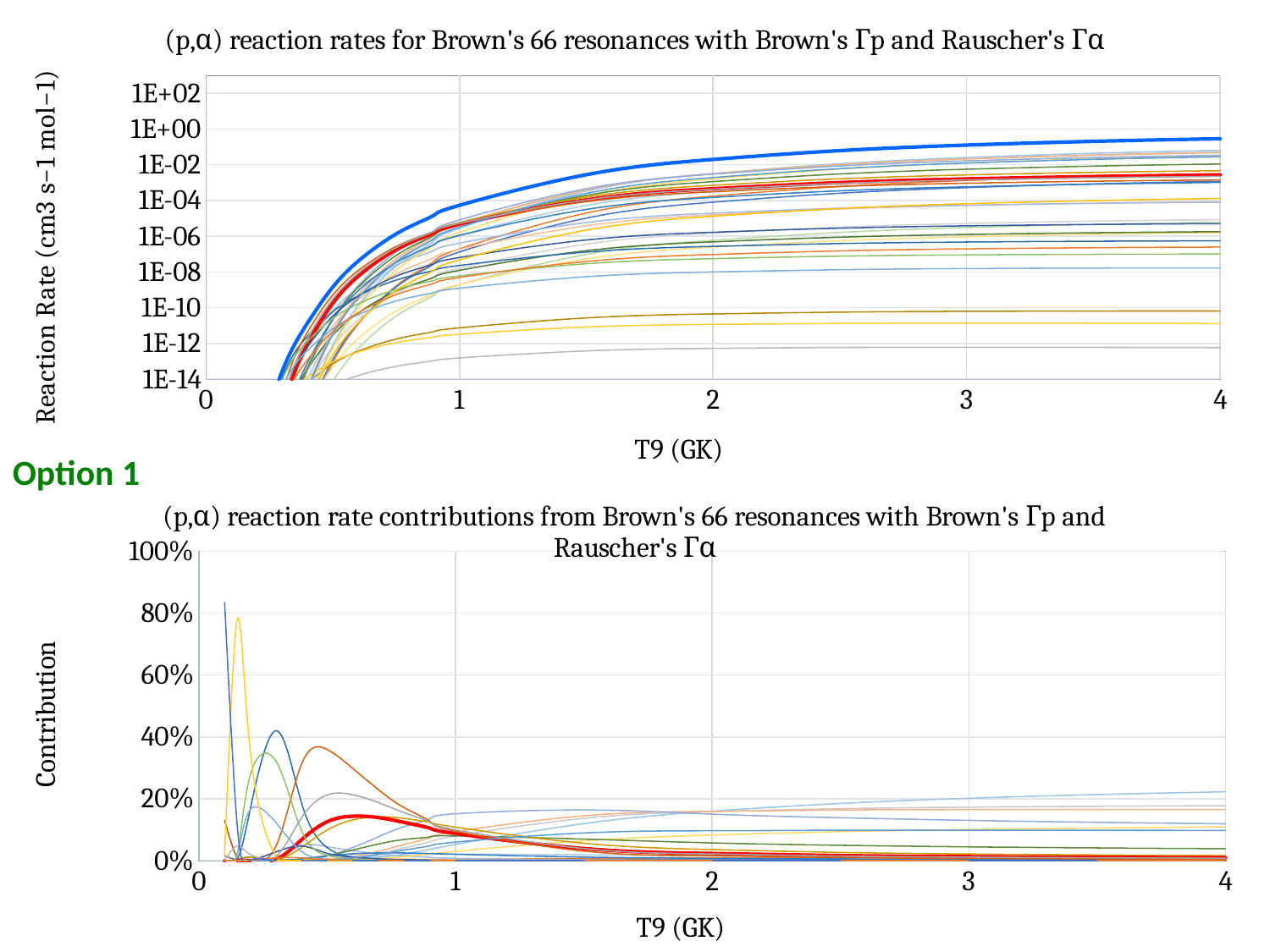
In the bottom chart, what is the label of the x axis? T9 (GK) In the top chart, is the value of the thick blue line at T9 = 4 greater or less than 1E+00? less In the top chart, is the value of the thick blue line at T9 = 4 greater or less than 1E-02? greater In the bottom chart, what is the highest value shown on the y axis? 100% In the top chart, does the thick blue line rise or fall as T9 increases from 0 to 4? Rises What kind of chart is the bottom chart, titled "(p,α) reaction rate contributions from Brown's 66 resonances with Brown's Γp and Rauscher's Γα"? Line chart What kind of chart is the top chart, titled "(p,α) reaction rates for Brown's 66 resonances with Brown's Γp and Rauscher's Γα"? Line chart In the bottom chart, is the peak value of the thick red line greater or less than 20%? less In the bottom chart, does the thick red line rise or fall as T9 increases from 1 to 4? Falls In the top chart, what is the label of the y axis? Reaction Rate (cm3 s-1 mol-1)